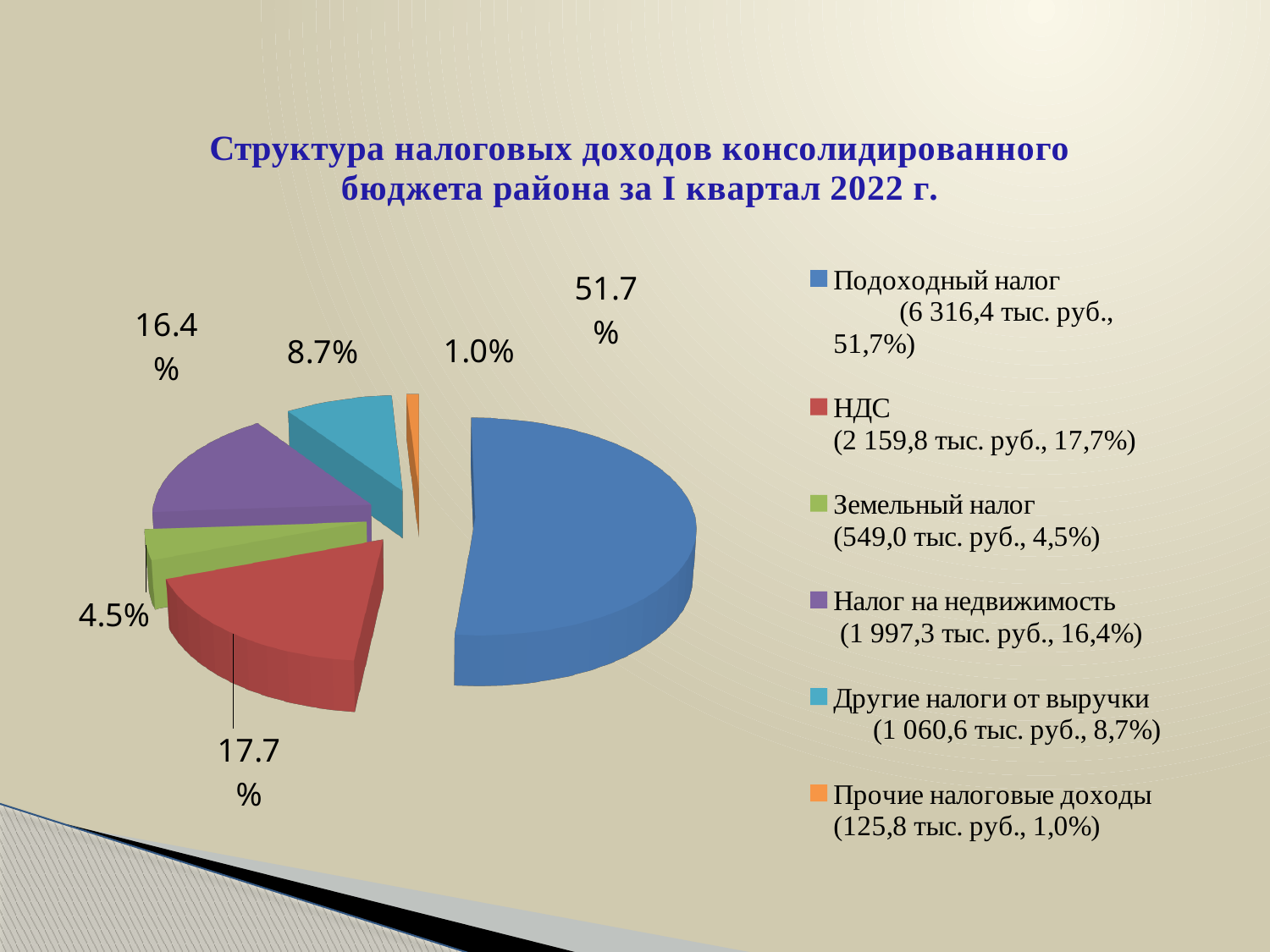
Which has a larger share, Другие налоги от выручки or Земельный налог? Другие налоги от выручки Which category has the largest slice of the pie? Подоходный налог What share of the pie does Налог на недвижимость have? 16.4% What share of the pie does Прочие налоговые доходы have? 1.0% How many slices does the pie chart have? 6 What share of the pie does Подоходный налог have? 51.7% What is the difference in percentage points between the shares of НДС and Налог на недвижимость? 1.3 What colour is the slice for НДС? red Which category has the smallest slice of the pie? Прочие налоговые доходы What kind of chart is shown on the slide? pie chart